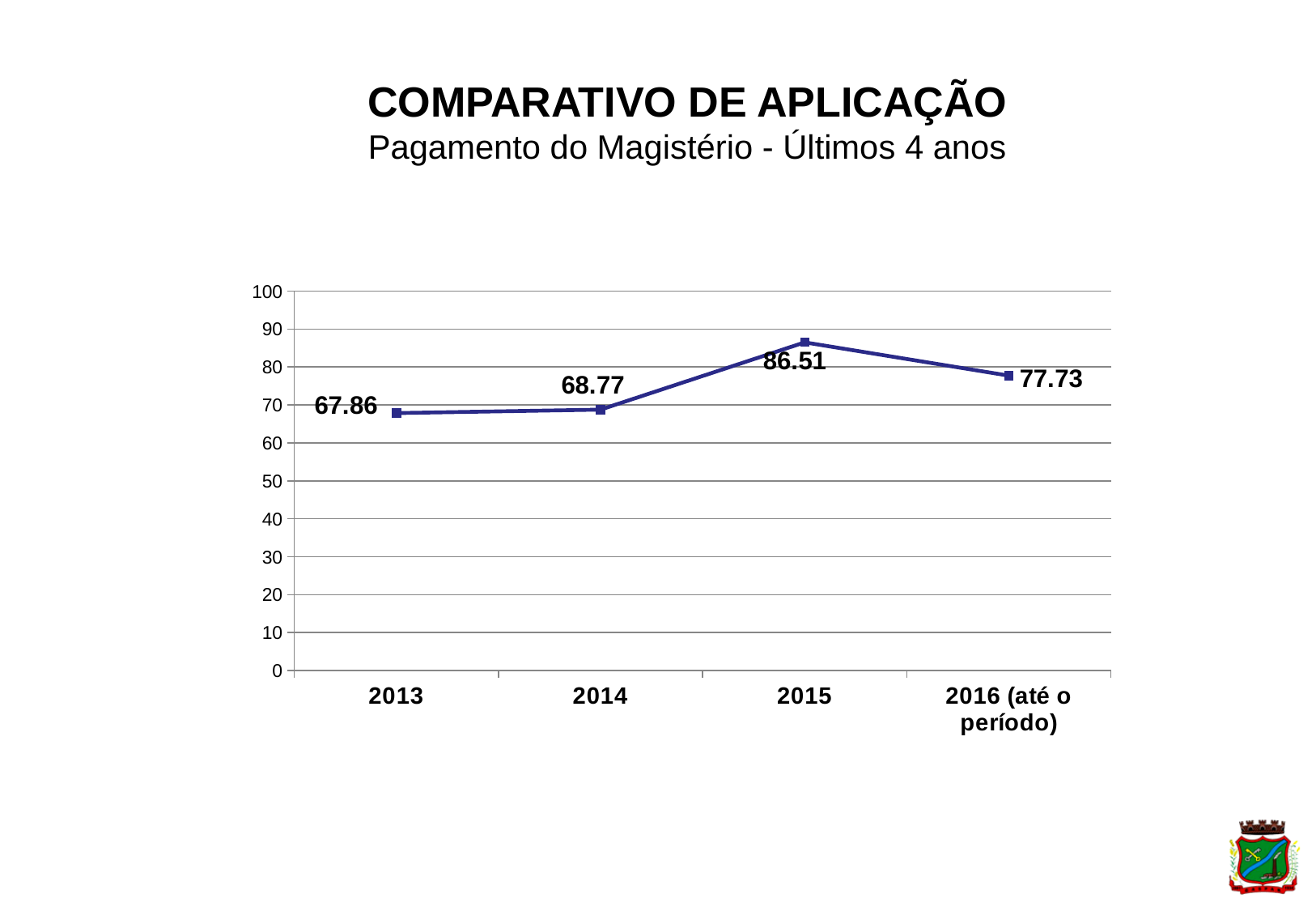
How many data points are plotted on the chart? 4 What kind of chart is shown on the slide? line chart What is the difference between the values for 2015 and 2014? 17.74 What is the value for 2013? 67.86 What is the subtitle of the chart on the slide? Pagamento do Magistério - Últimos 4 anos Is the value for 2015 greater or less than 80? greater Which year has the highest value? 2015 What is the value for 2016 (até o período)? 77.73 Which year has the lowest value? 2013 What is the value for 2015? 86.51 Which is larger, the value for 2016 (até o período) or the value for 2014? 2016 (até o período) Does the value rise or fall from 2015 to 2016 (até o período)? fall